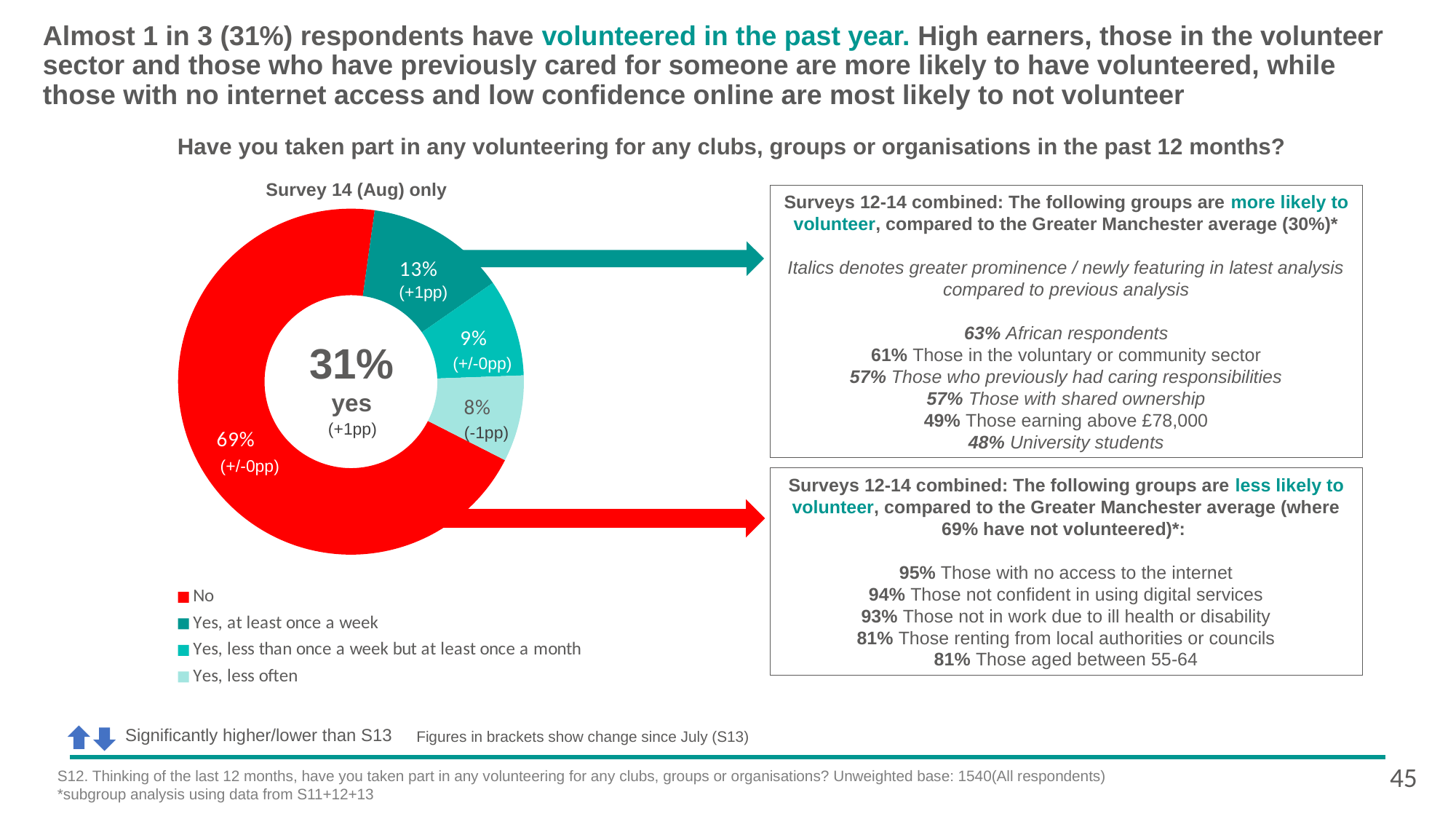
What change since July (S13) is shown in brackets for the "Yes, less often" segment? -1pp What percentage of respondents said "Yes, at least once a week"? 13% Which category has the largest share of the donut chart? No What type of chart is shown on the slide? Donut (pie) chart What percentage of respondents answered "No" in the donut chart? 69% What overall percentage of respondents answered "yes", as shown in the centre of the donut chart? 31% Which category has the smallest share of the donut chart? Yes, less often What is the difference in percentage points between "No" and "Yes, at least once a week"? 56 percentage points What percentage of respondents said "Yes, less often"? 8% Which is larger: the share for "Yes, at least once a week" or "Yes, less often"? Yes, at least once a week How many categories does the donut chart's legend list? 4 What percentage of respondents said "Yes, less than once a week but at least once a month"? 9%